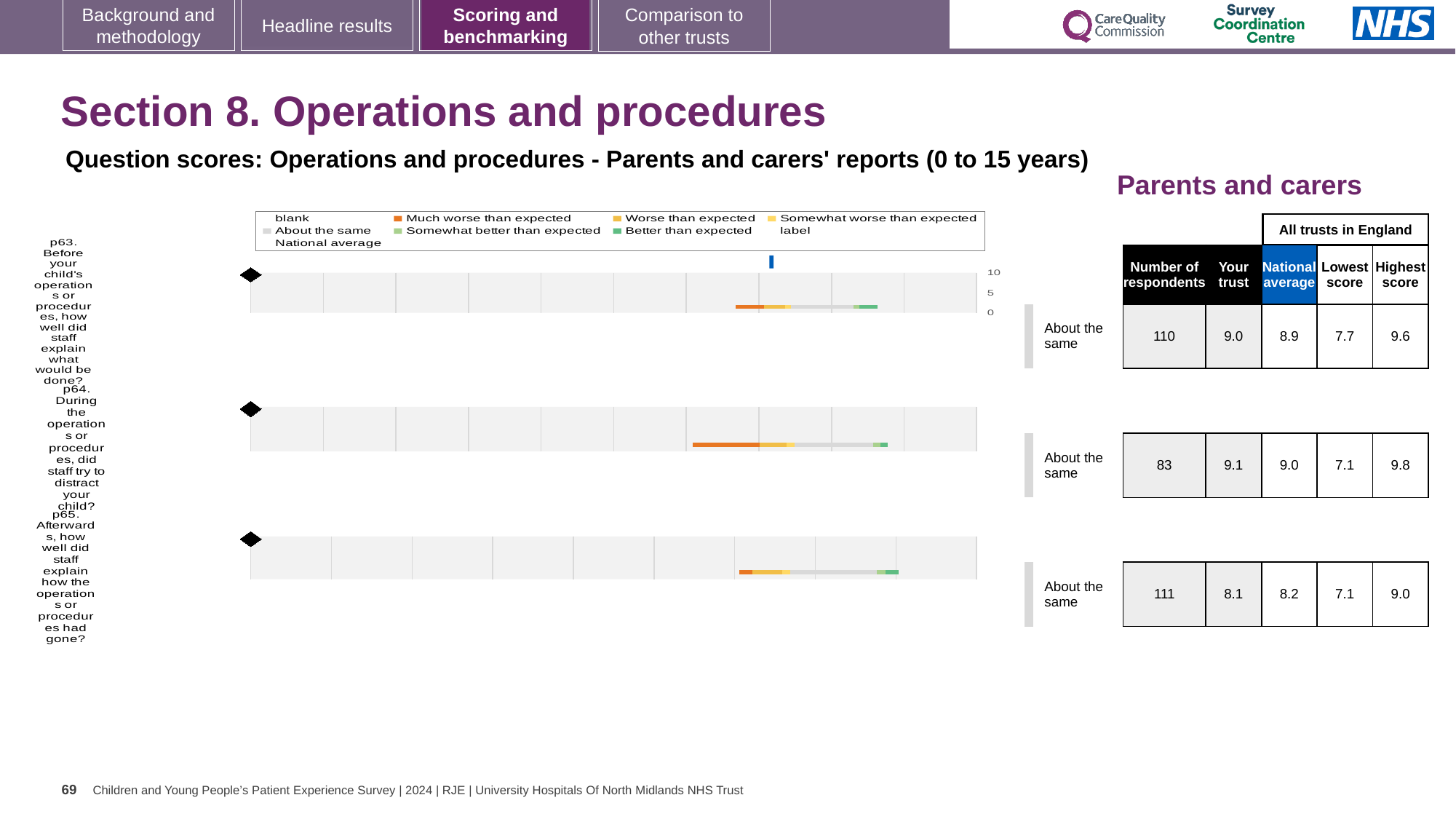
What is the national average score for p64 (During the operations or procedures, did staff try to distract your child?)? 9.0 What is the highest score across all trusts in England for p64? 9.8 What is the 'Your trust' score for p63 (Before your child's operations or procedures, how well did staff explain what would be done?)? 9.0 What is the difference between the highest score and the lowest score for p63? 1.9 What kind of chart is used to show the question scores on this slide? bar chart For p65, which is larger: the 'Your trust' score or the national average? National average What is the title of the table to the right of the charts? Parents and carers How many respondents answered p65 (Afterwards, how well did staff explain how the operations or procedures had gone?)? 111 Which question has the lowest 'Your trust' score? p65 How many questions (p63, p64, p65) are plotted on the slide? 3 Which question has the highest 'Your trust' score? p64 What benchmark category is shown for p64? About the same